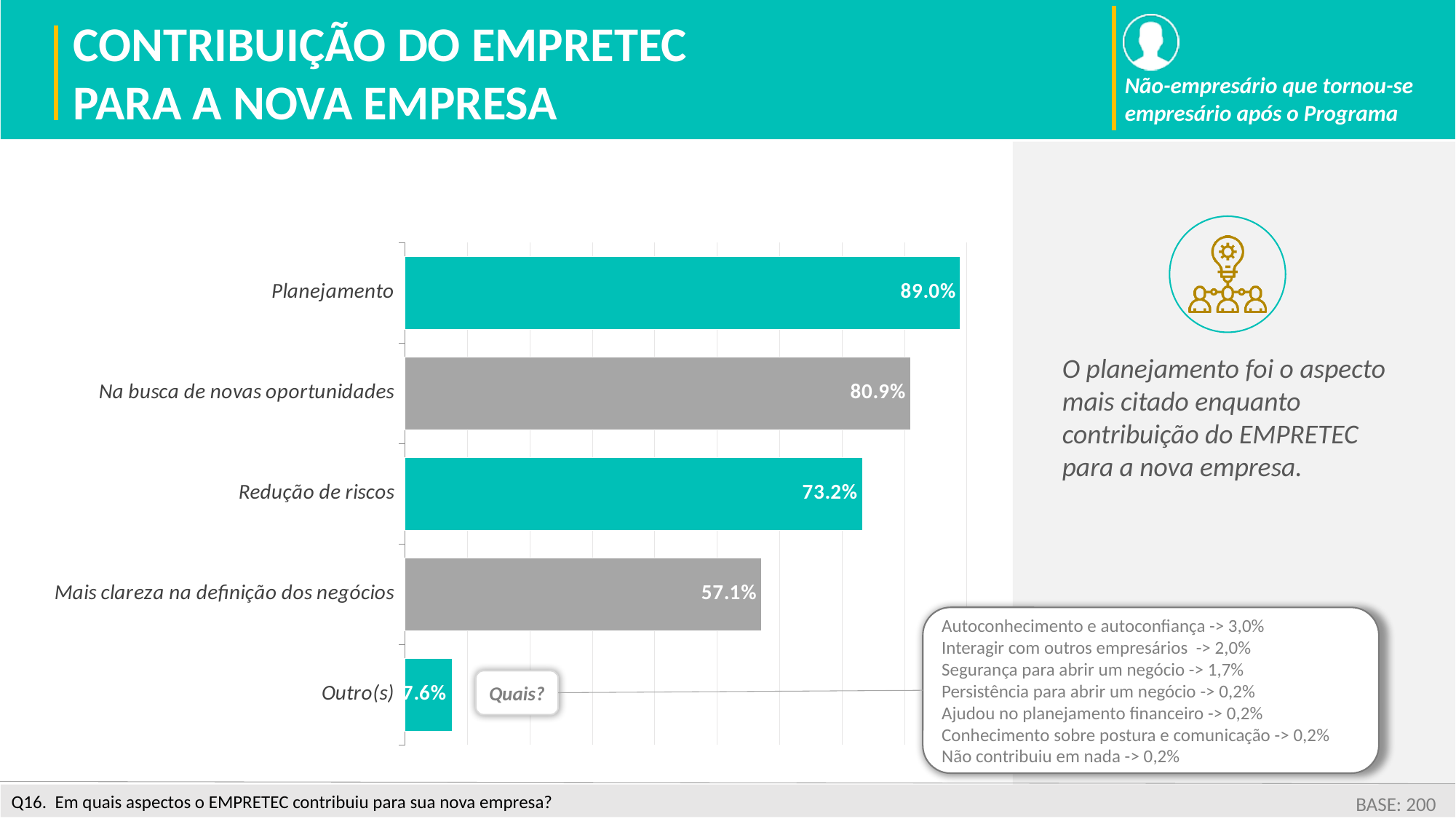
What is the value for Planejamento? 89.0% What is the difference between the values for Redução de riscos and Mais clareza na definição dos negócios? 16.1% Which category has the lowest value? Outro(s) Which is larger, the value for Redução de riscos or the value for Mais clareza na definição dos negócios? Redução de riscos What kind of chart is shown on the slide? Bar chart What is the value for Na busca de novas oportunidades? 80.9% How many categories are shown in the chart? 5 What is the value for Redução de riscos? 73.2% What is the difference between the values for Planejamento and Na busca de novas oportunidades? 8.1% What is the value for Mais clareza na definição dos negócios? 57.1% Which category has the highest value? Planejamento What is the value for Outro(s)? 7.6%